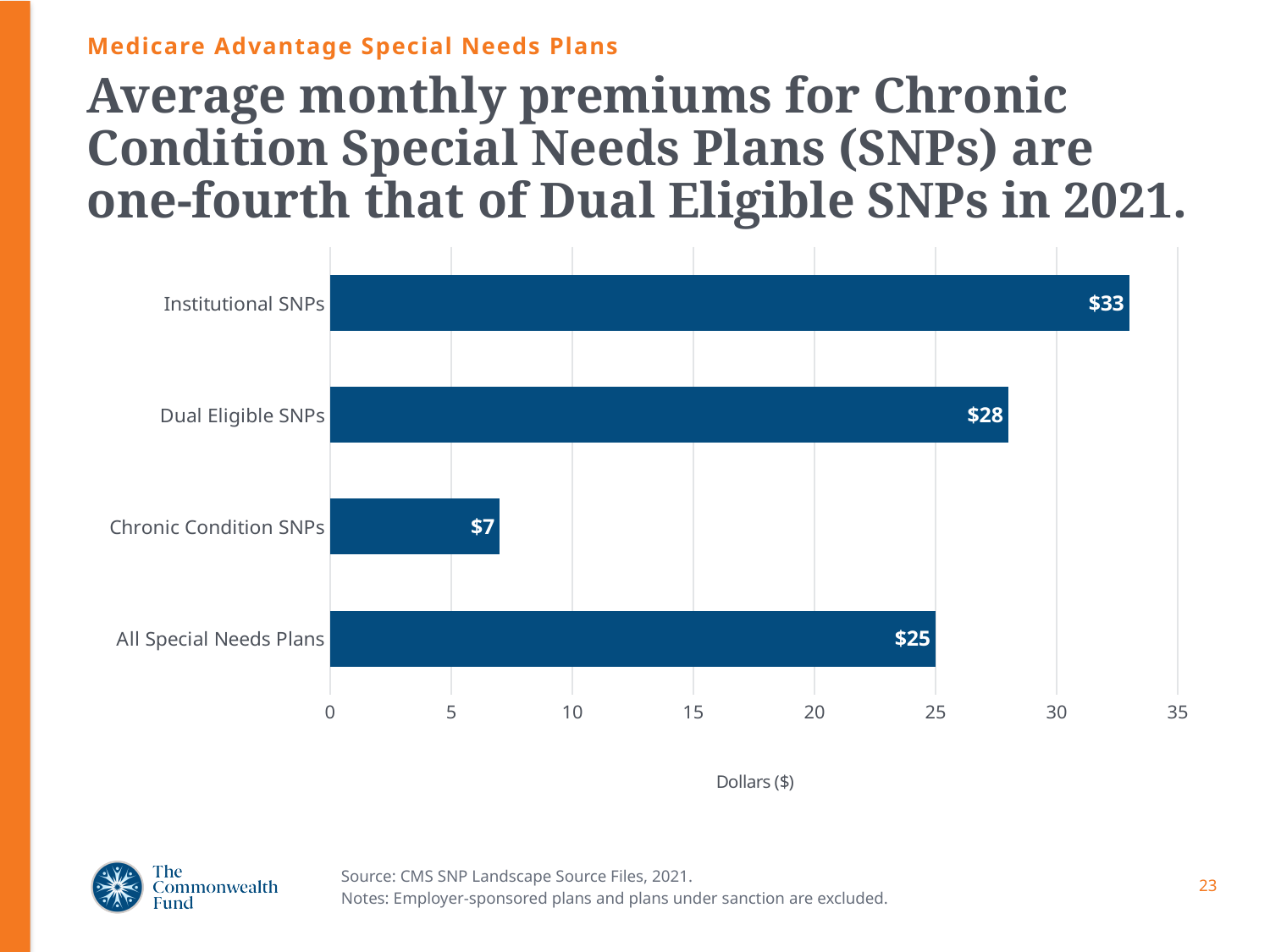
What is the average monthly premium for Chronic Condition SNPs? $7 How many categories are shown in the chart? 4 Which has a higher average monthly premium, Institutional SNPs or All Special Needs Plans? Institutional SNPs Is the value for Dual Eligible SNPs greater or less than 25? greater What is the average monthly premium for All Special Needs Plans? $25 What is the label of the x axis? Dollars ($) What is the average monthly premium for Institutional SNPs? $33 What kind of chart is shown on the slide? Bar chart Which category has the highest average monthly premium? Institutional SNPs What is the average monthly premium for Dual Eligible SNPs? $28 What is the difference between the average monthly premium for Dual Eligible SNPs and Chronic Condition SNPs? $21 Which category has the lowest average monthly premium? Chronic Condition SNPs